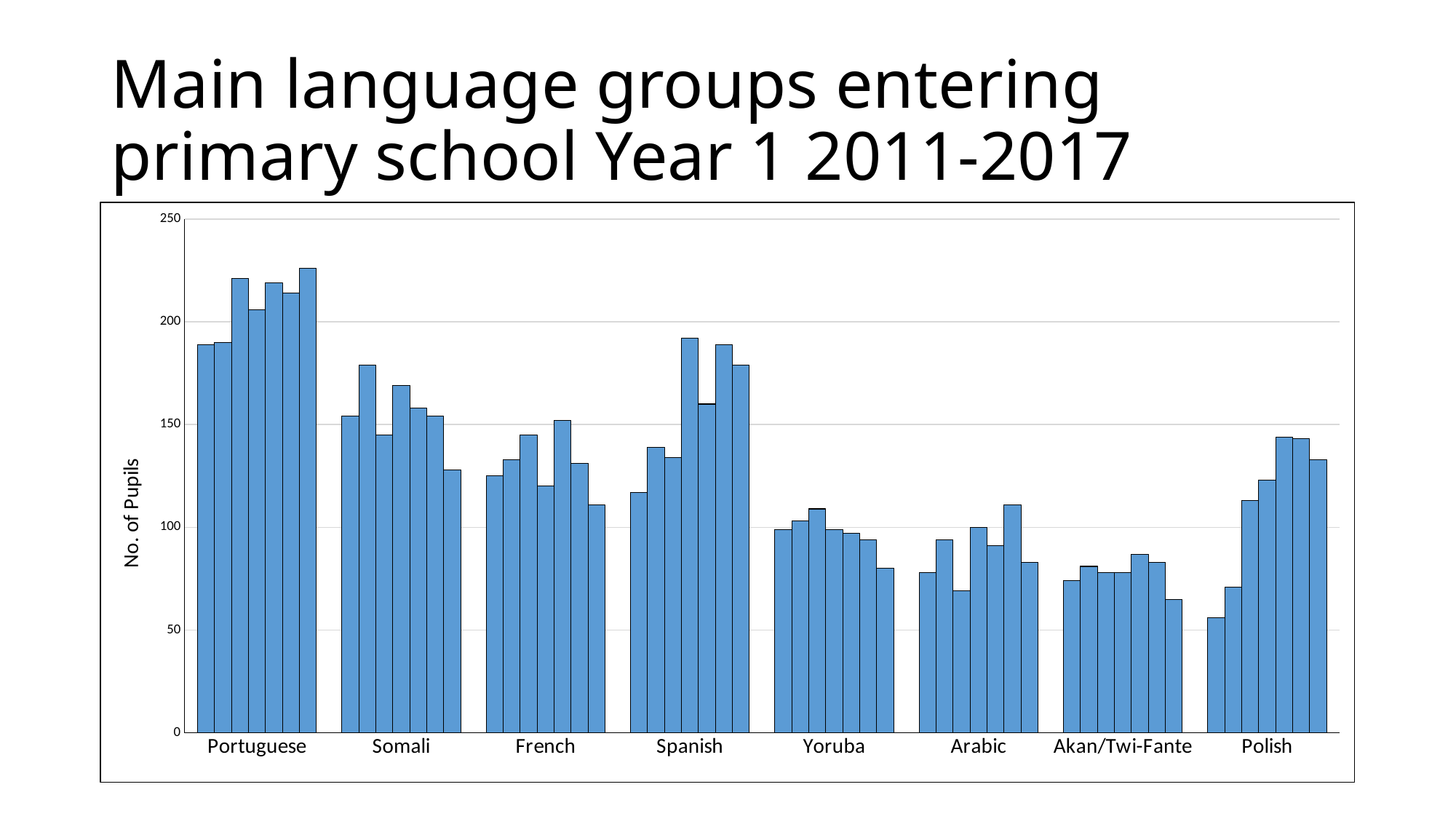
Which language group has the highest bars overall? Portuguese How many language groups are shown on the x axis? 8 What is the label on the y axis? No. of Pupils Are all the bars for Portuguese greater or less than 150? greater Do the bars for Polish generally rise or fall from left to right? rise Is the tallest bar for Spanish greater or less than 150? greater Is the first (leftmost) bar for Polish greater or less than 100? less Which is larger, the first bar for Somali or the first bar for French? Somali Which language group contains the lowest bar on the chart? Polish What kind of chart is shown on the slide? Bar chart How many bars are plotted for each language group? 7